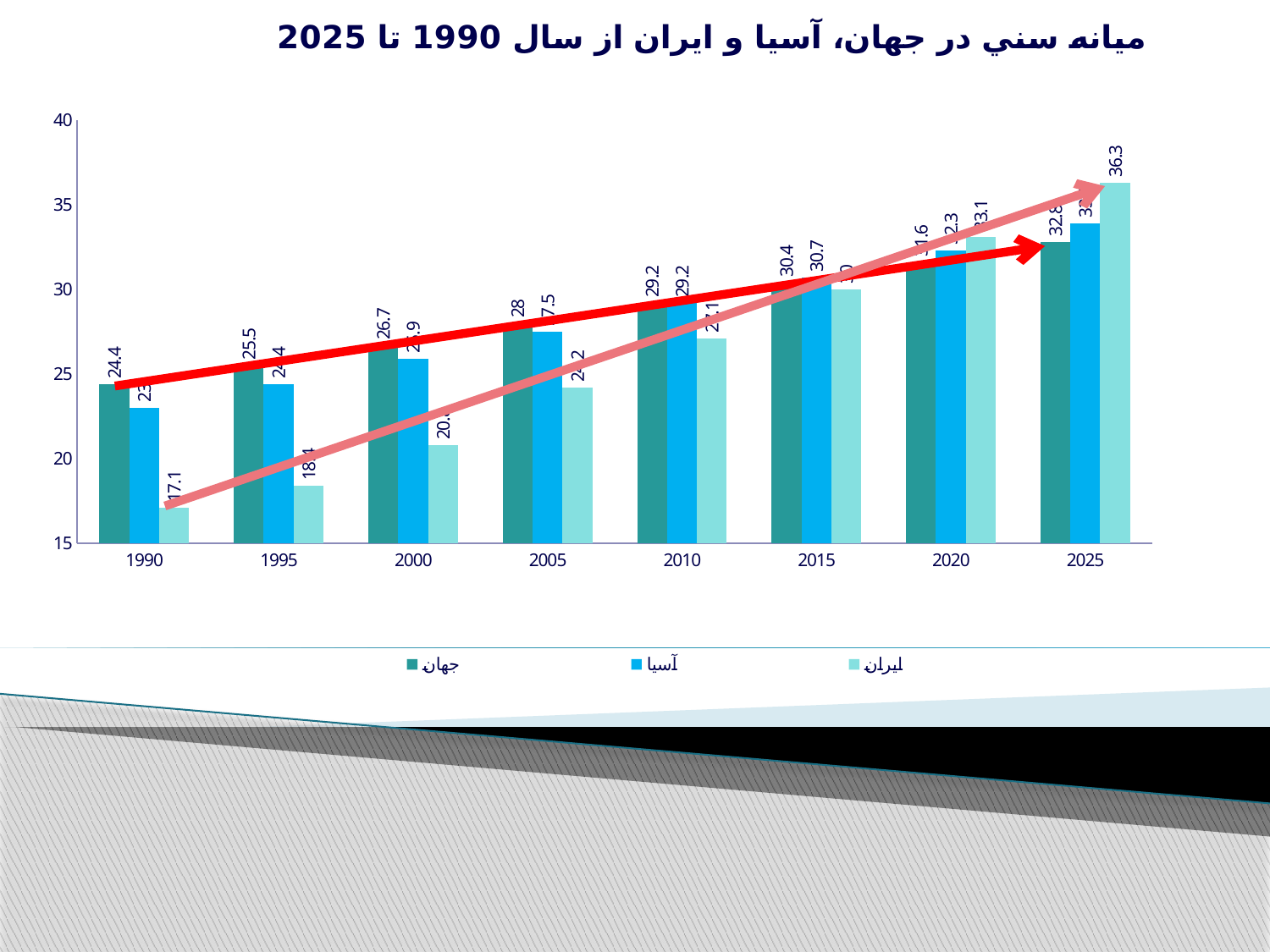
Which series has the lowest value in 1990? ایران (Iran) Is the value for ایران (Iran) in 2000 greater or less than 25? less What is the value for ایران (Iran) in 2025? 36.3 What is the difference between the جهان (World) value and the ایران (Iran) value in 1990? 7.3 Which series has the highest value in 2025? ایران (Iran) How many series does the legend list? 3 What is the difference between the ایران (Iran) value and the جهان (World) value in 2025? 3.5 What is the value for جهان (World) in 1990? 24.4 What kind of chart is shown on the slide? Bar chart What is the value for جهان (World) in 2025? 32.8 What is the value for ایران (Iran) in 1990? 17.1 How many years are shown on the x axis? 8